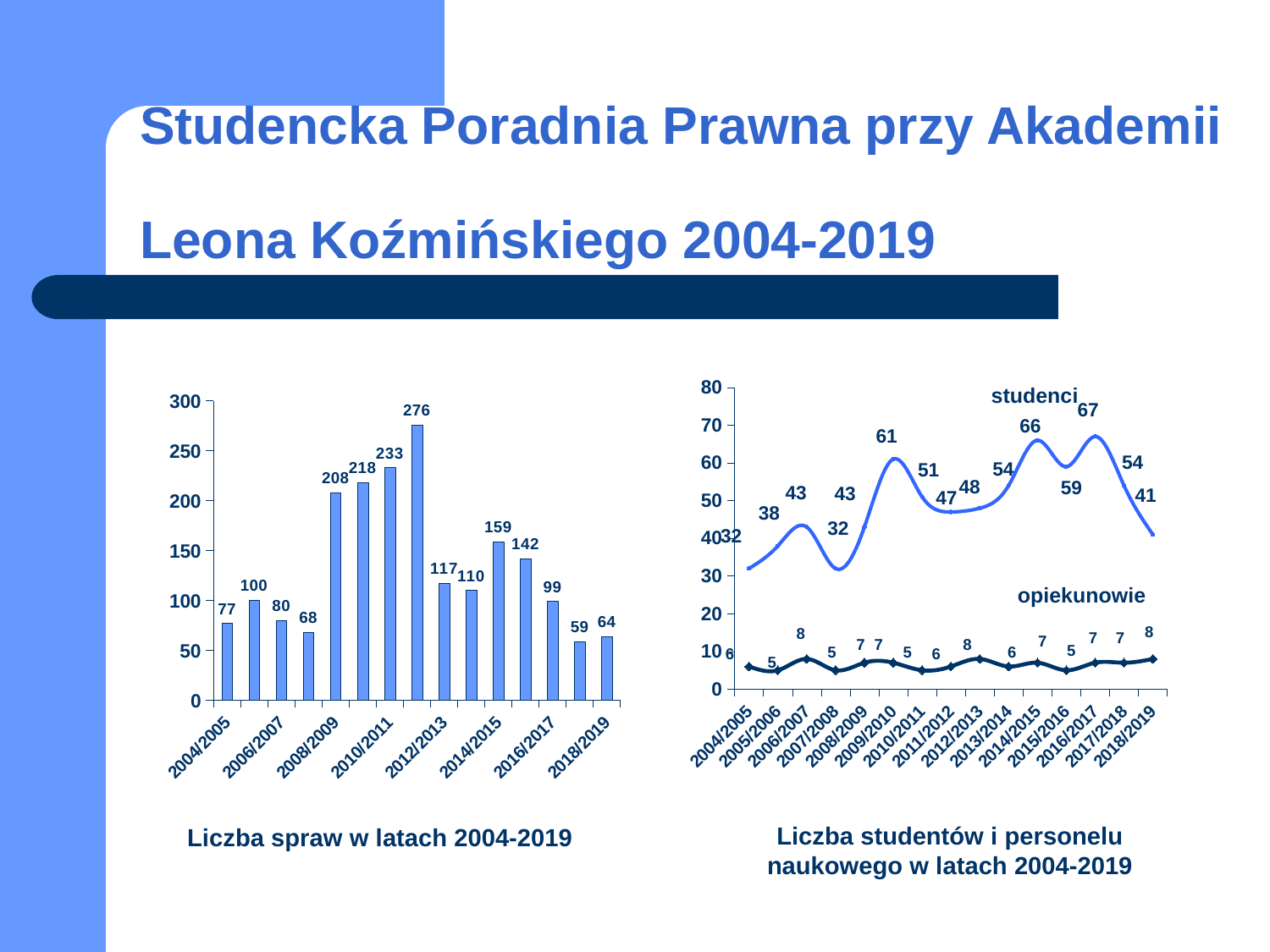
On the chart titled 'Liczba spraw w latach 2004-2019', how many bars are plotted? 15 On the chart titled 'Liczba studentów i personelu naukowego w latach 2004-2019', in which year is the studenci value highest? 2016/2017 On the chart titled 'Liczba spraw w latach 2004-2019', what is the value for 2010/2011? 233 On the chart titled 'Liczba studentów i personelu naukowego w latach 2004-2019', what is the value for opiekunowie in 2012/2013? 8 On the chart titled 'Liczba studentów i personelu naukowego w latach 2004-2019', what kind of chart is shown? line chart On the chart titled 'Liczba studentów i personelu naukowego w latach 2004-2019', how many series are plotted? 2 On the chart titled 'Liczba spraw w latach 2004-2019', what is the difference between the values for 2008/2009 and 2004/2005? 131 On the chart titled 'Liczba spraw w latach 2004-2019', what is the value for 2018/2019? 64 On the chart titled 'Liczba spraw w latach 2004-2019', which is larger, the value for 2012/2013 or for 2014/2015? 2014/2015 On the chart titled 'Liczba spraw w latach 2004-2019', what is the highest value shown? 276 On the chart titled 'Liczba studentów i personelu naukowego w latach 2004-2019', what is the value for studenci in 2009/2010? 61 On the chart titled 'Liczba spraw w latach 2004-2019', what kind of chart is shown? bar chart